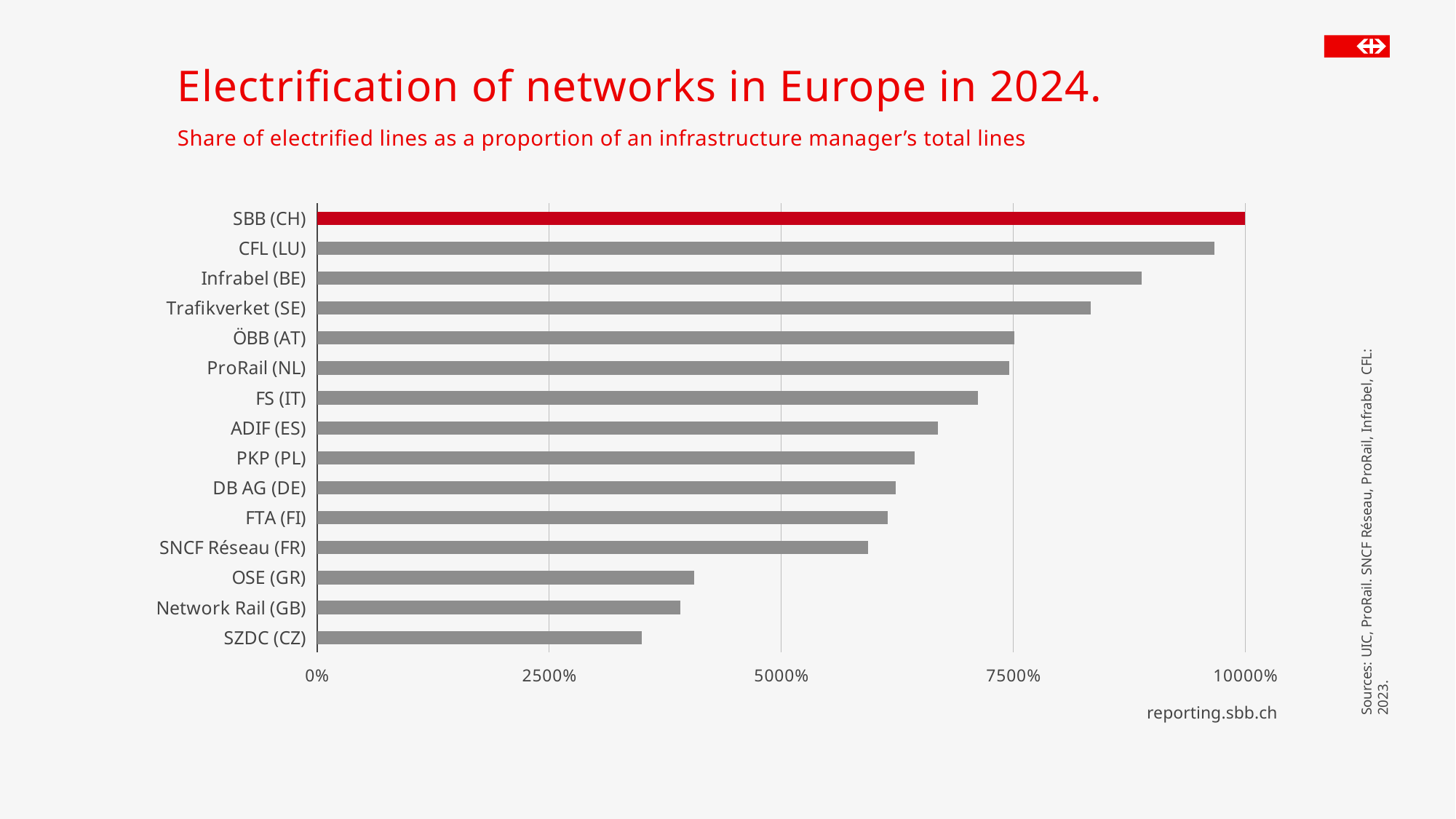
Is the value for Network Rail (GB) greater or less than 2500%? greater How many infrastructure managers are listed in the chart? 15 Which infrastructure manager has the highest share of electrified lines? SBB (CH) Is the value for DB AG (DE) greater or less than 5000%? greater Which infrastructure manager has the lowest share of electrified lines? SZDC (CZ) Which infrastructure manager's bar is highlighted in red? SBB (CH) What kind of chart is shown on the slide? bar chart Is the value for SZDC (CZ) greater or less than 5000%? less Do the bar values rise or fall going from the top of the chart to the bottom? fall Which has the larger value, CFL (LU) or Infrabel (BE)? CFL (LU)